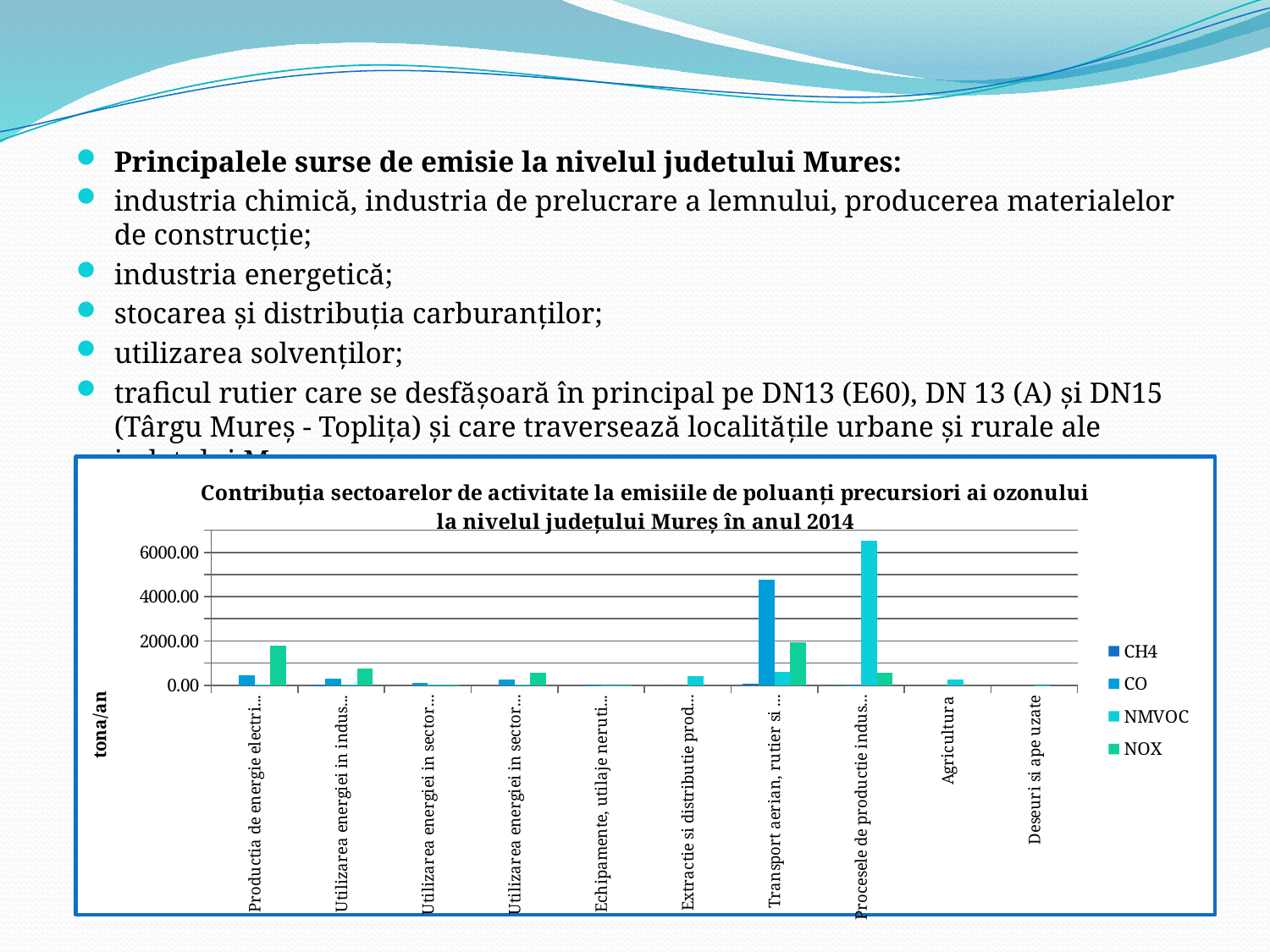
How many activity sector categories are shown on the x axis? 10 How many series does the legend list? 4 Which year does the chart title say the emissions data refer to? 2014 Is the NOX value for 'Productia de energie electri...' greater or less than 2000.00? less In which category does the NMVOC series reach its highest value? Procesele de productie indus... What kind of chart is shown on the slide? bar chart For 'Transport aerian, rutier si ...', which is larger: the CO value or the NOX value? CO Is the CO value for 'Transport aerian, rutier si ...' greater or less than 4000.00? greater What is the label on the vertical axis of the chart? tona/an Is the NMVOC value for 'Procesele de productie indus...' greater or less than 6000.00? greater Which series has the highest value in the 'Productia de energie electri...' category? NOX Which pollutant series has the tallest bar in the whole chart? NMVOC